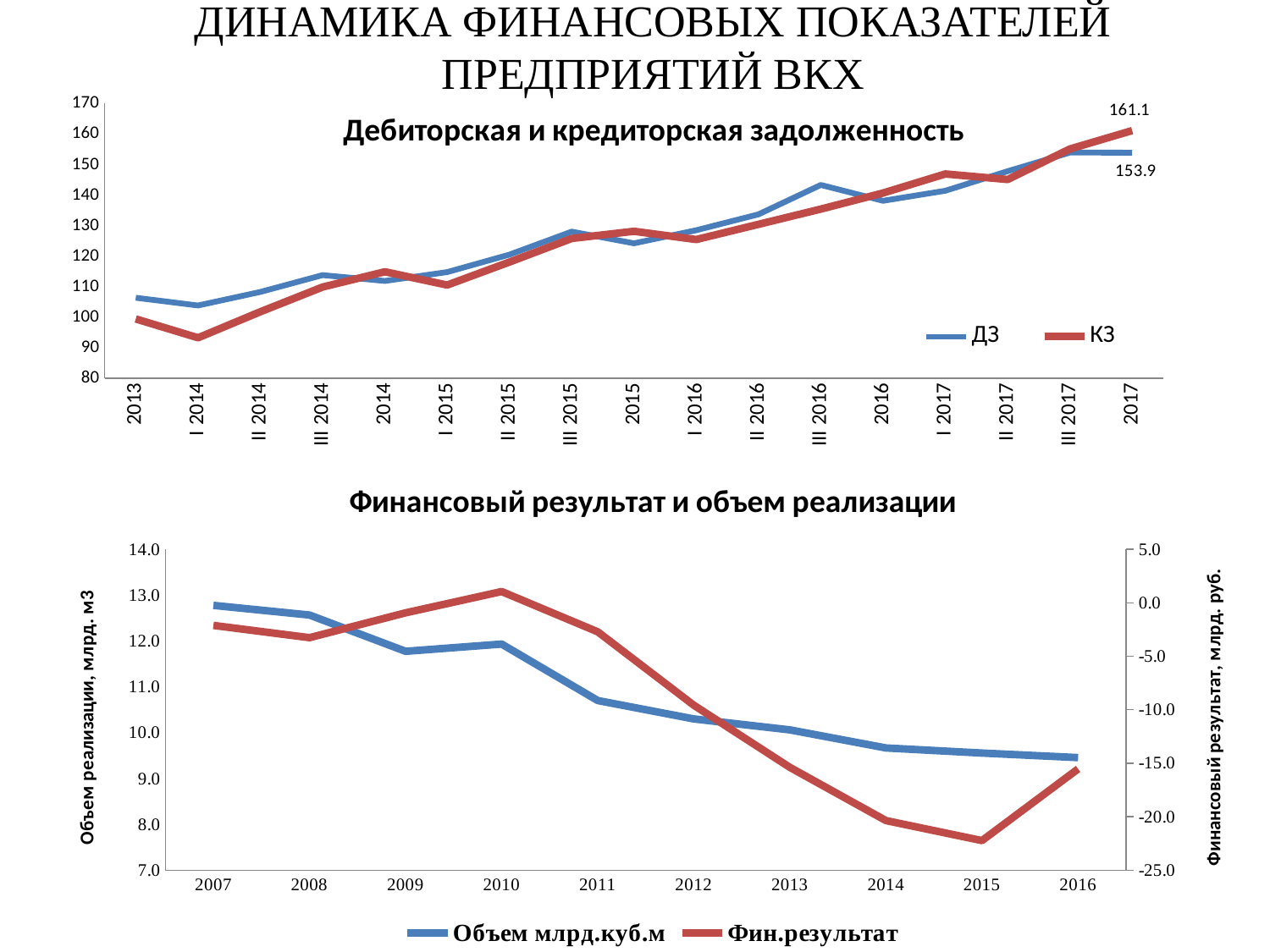
In the top chart (Дебиторская и кредиторская задолженность), how many series does the legend list? 2 In the top chart (Дебиторская и кредиторская задолженность), what is the value of КЗ in 2017? 161.1 In the bottom chart (Финансовый результат и объем реализации), how many years are shown on the x axis? 10 In the top chart (Дебиторская и кредиторская задолженность), which series has the larger value in 2017, ДЗ or КЗ? КЗ In the bottom chart (Финансовый результат и объем реализации), in which year is Фин.результат lowest? 2015 In the top chart (Дебиторская и кредиторская задолженность), what is the difference between КЗ and ДЗ in 2017? 7.2 In the top chart (Дебиторская и кредиторская задолженность), do the values of ДЗ generally rise or fall from 2013 to 2017? rise In the top chart (Дебиторская и кредиторская задолженность), is the value of КЗ for I 2014 greater or less than 100? less In the bottom chart (Финансовый результат и объем реализации), is the value of Объем млрд.куб.м in 2007 greater or less than 12.0? greater What kind of chart is the bottom chart (Финансовый результат и объем реализации)? line chart In the top chart (Дебиторская и кредиторская задолженность), what is the value of ДЗ in 2017? 153.9 In the top chart (Дебиторская и кредиторская задолженность), how many points are on the x axis? 17